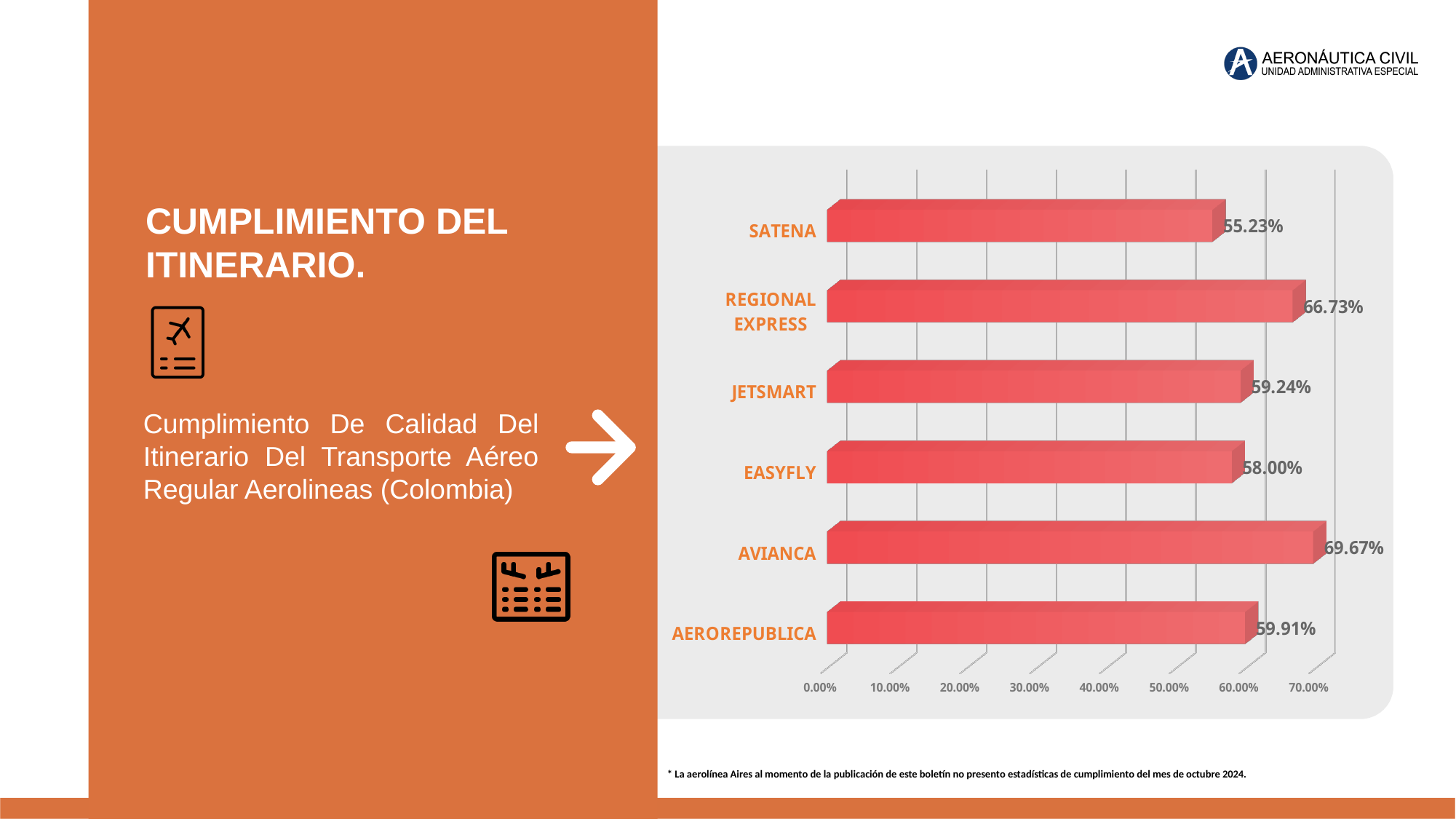
How many airlines are shown in the chart? 6 What is the value for SATENA? 55.23% What kind of chart is shown on the slide? bar chart What is the value for AVIANCA? 69.67% What is the value for REGIONAL EXPRESS? 66.73% What is the difference between the values for AVIANCA and SATENA? 14.44% What is the highest tick label shown on the value axis? 70.00% Which airline has the highest value? AVIANCA Which is larger, the value for JETSMART or the value for AEROREPUBLICA? AEROREPUBLICA What is the value for EASYFLY? 58.00% Is the value for REGIONAL EXPRESS greater or less than 60.00%? greater Which airline has the lowest value? SATENA